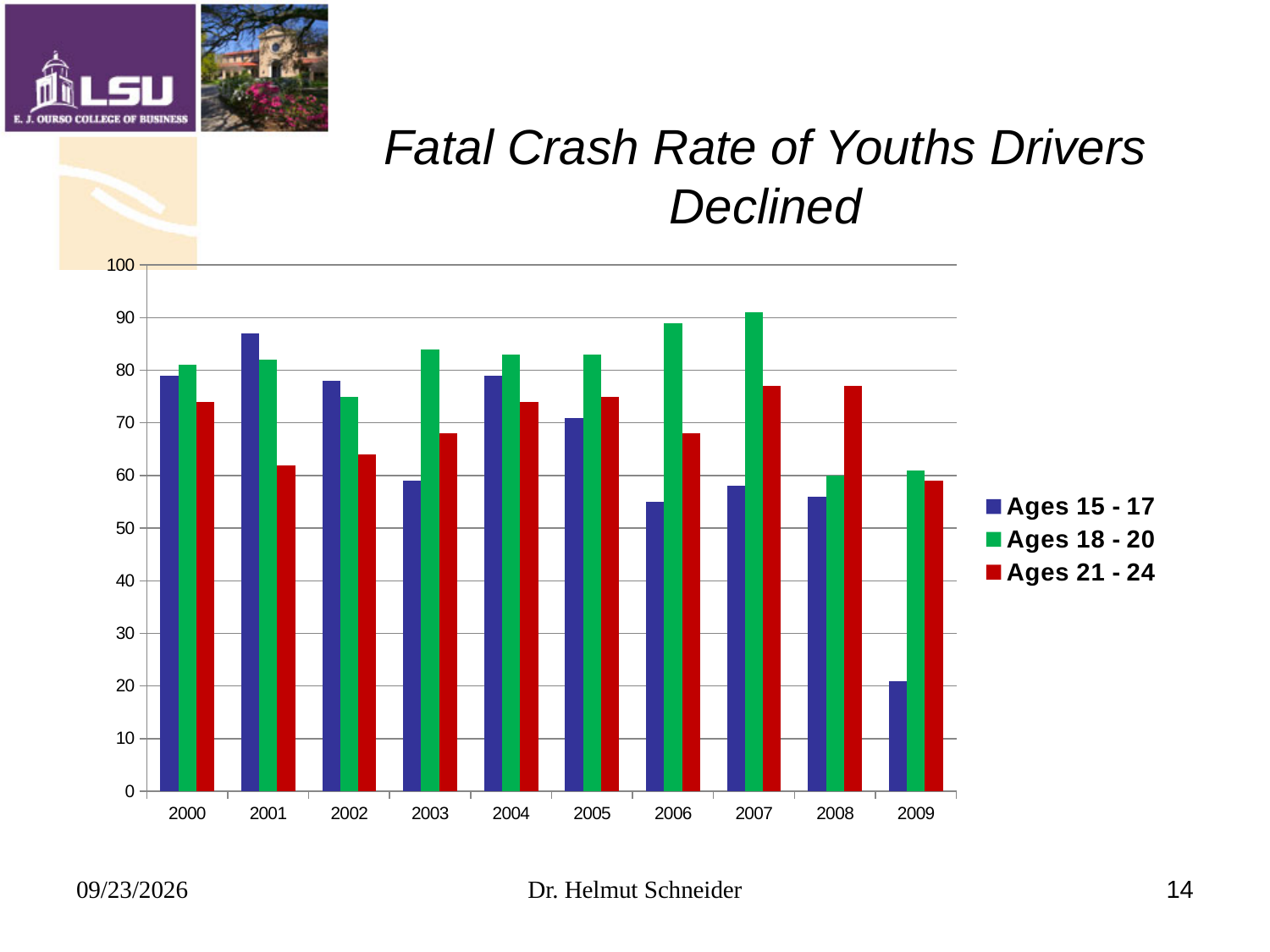
How many series does the legend list? 3 In 2001, which is larger: Ages 15 - 17 or Ages 21 - 24? Ages 15 - 17 Is the value for Ages 21 - 24 in 2008 greater or less than 70? greater Overall, do the Ages 15 - 17 values rise or fall from 2000 to 2009? fall In 2003, which is larger: Ages 15 - 17 or Ages 18 - 20? Ages 18 - 20 Is the value for Ages 18 - 20 in 2006 greater or less than 80? greater What kind of chart is shown on the slide? bar chart How many years are shown along the x axis? 10 What colour are the Ages 18 - 20 bars? green Is the value for Ages 15 - 17 in 2009 greater or less than 30? less In which year is the Ages 15 - 17 bar the lowest? 2009 In which year is the Ages 15 - 17 bar the highest? 2001